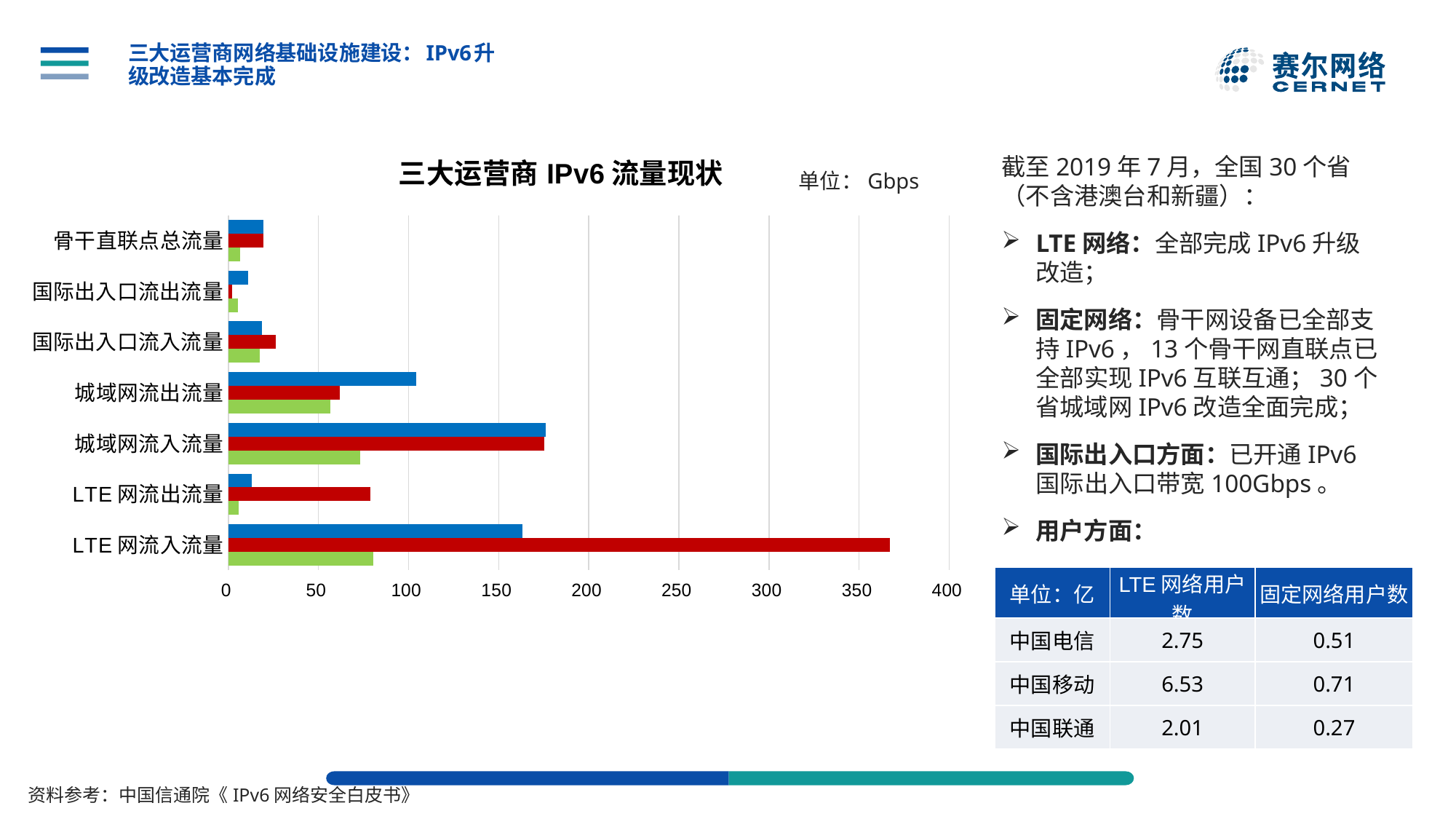
Is the value of the green bar for LTE 网流出流量 greater or less than 50? less Is the value of the red bar for 国际出入口流出流量 greater or less than 50? less Which is larger: the red bar for LTE 网流入流量 or the red bar for 城域网流入流量? LTE 网流入流量 What kind of chart is shown on the slide? bar chart What unit is stated for the chart's values? Gbps How many bars are plotted for each category on the chart? 3 Is the value of the red bar for LTE 网流入流量 greater or less than 350? greater What is the title of the chart? 三大运营商 IPv6 流量现状 Which is larger: the blue bar for 城域网流入流量 or the blue bar for 城域网流出流量? 城域网流入流量 How many categories are shown on the chart's vertical axis? 7 Which category contains the longest bar on the chart? LTE 网流入流量